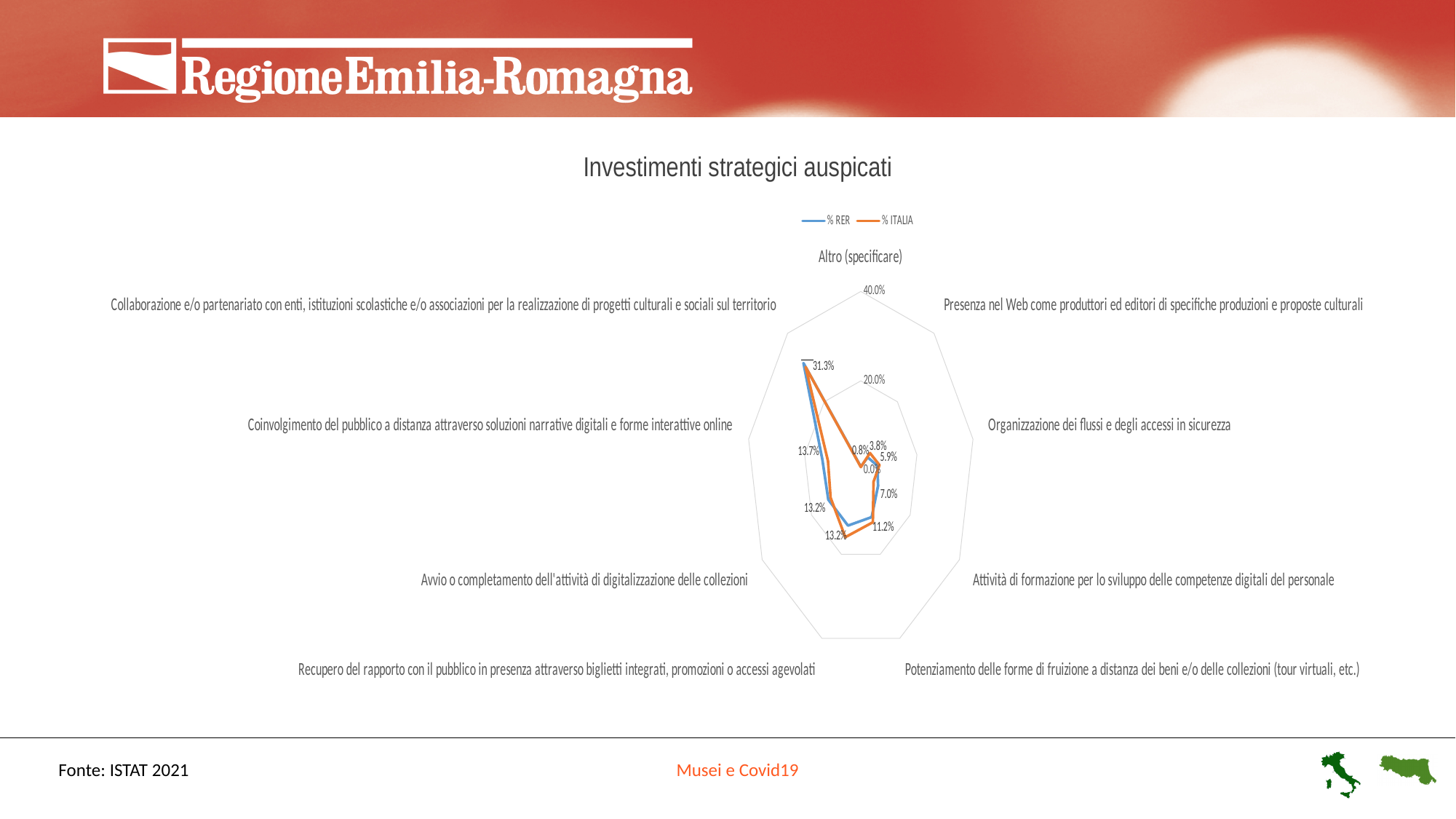
Which category has the highest values for both series? Collaborazione e/o partenariato con enti, istituzioni scolastiche e/o associazioni per la realizzazione di progetti culturali e sociali sul territorio What is the largest data label printed on the chart? 31.3% Which category has larger values: Collaborazione e/o partenariato con enti or Altro (specificare)? Collaborazione e/o partenariato con enti What are the two series named in the legend? % RER and % ITALIA Is the value for Altro (specificare) greater or less than 20.0%? less What kind of chart is shown on the slide? radar chart What is the outermost axis value shown on the radar chart? 40.0% How many series does the legend list? 2 What is the title of the chart? Investimenti strategici auspicati Is the value for Presenza nel Web come produttori ed editori greater or less than 20.0%? less Is the value for Collaborazione e/o partenariato con enti greater or less than 20.0%? greater How many categories (axes) does the radar chart have? 9